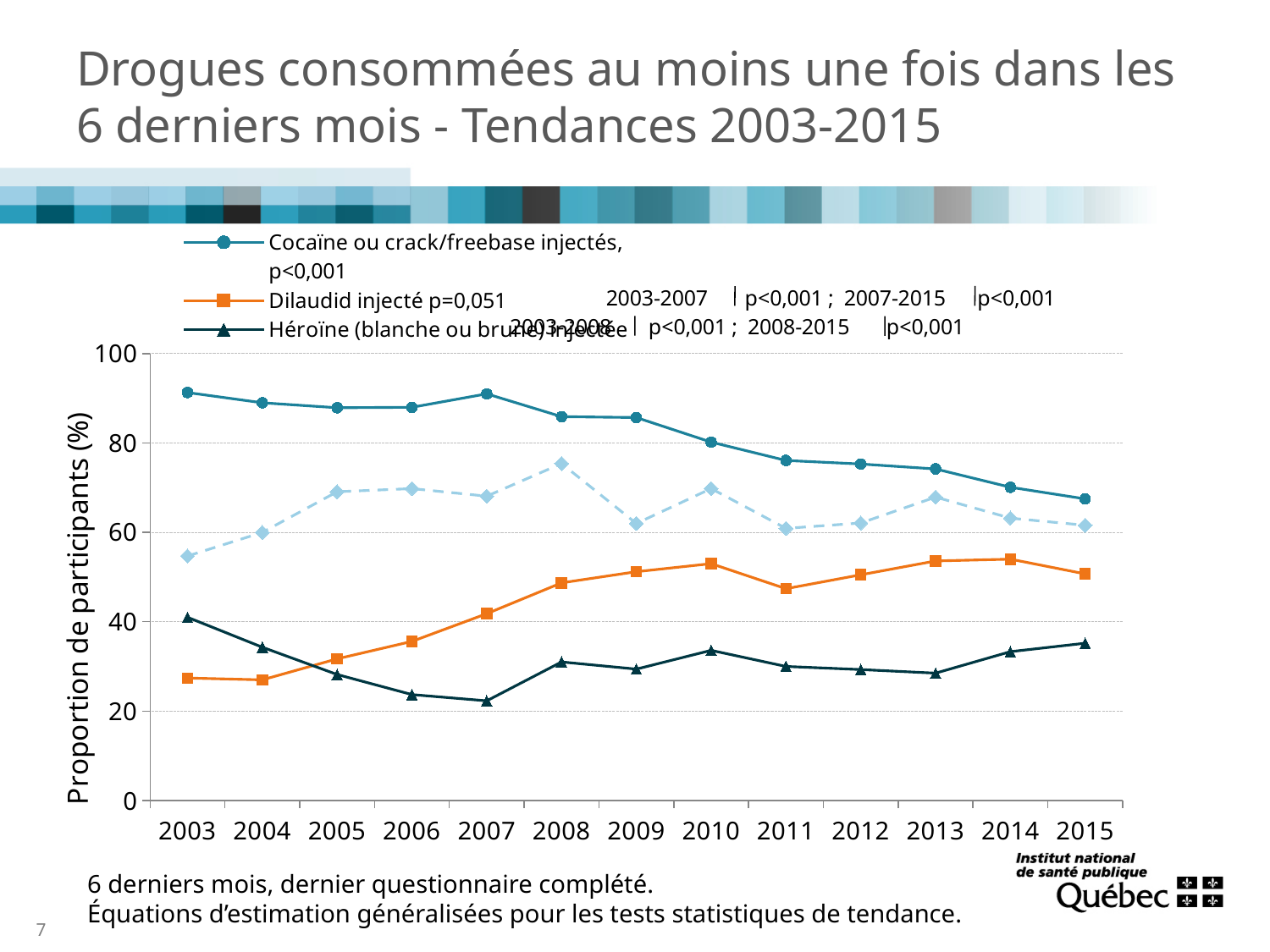
What is the label of the y axis? Proportion de participants (%) Is the value for Cocaïne ou crack/freebase injectés in 2003 greater or less than 80? greater Which series has the lowest value in 2015? Héroïne (blanche ou brune) injectée Is the value for Dilaudid injecté in 2003 greater or less than 40? less How many years are plotted along the x axis? 13 How many series does the legend list? 3 In 2010, which is larger: Cocaïne ou crack/freebase injectés or Héroïne (blanche ou brune) injectée? Cocaïne ou crack/freebase injectés Is the value for Dilaudid injecté in 2014 greater or less than 40? greater Does the Dilaudid injecté series rise or fall from 2003 to 2015? rise What kind of chart is shown on the slide? line chart Does the Cocaïne ou crack/freebase injectés series rise or fall from 2003 to 2015? fall